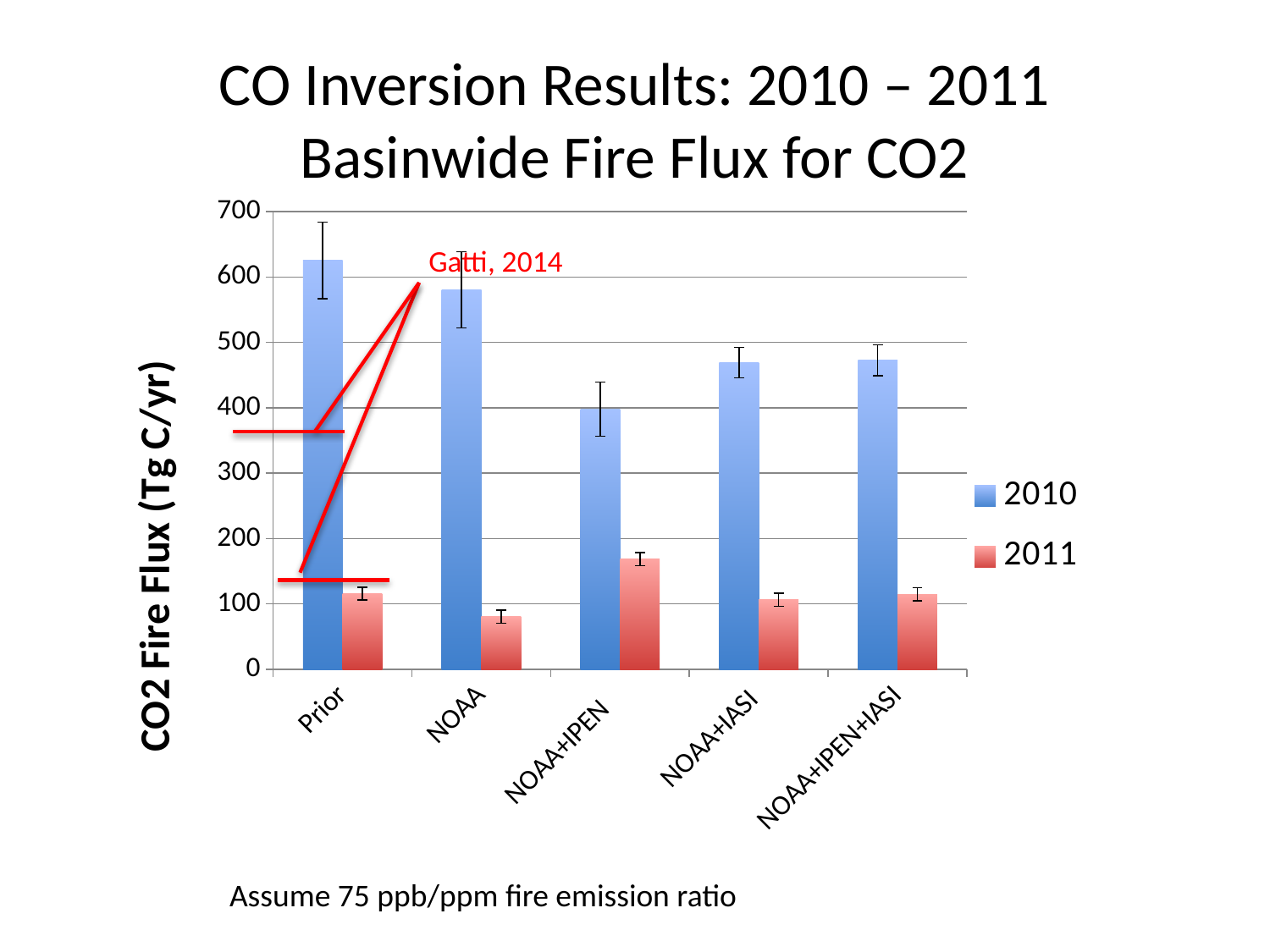
What is the label on the vertical axis? CO2 Fire Flux (Tg C/yr) Is the 2011 value for NOAA greater or less than 100? less Which category has the lowest 2010 value? NOAA+IPEN Is the 2011 value for NOAA+IPEN greater or less than 200? less How many categories are shown on the x axis? 5 Which category has the lowest 2011 value? NOAA What kind of chart is shown on the slide? bar chart Which category has the highest 2010 value? Prior How many series does the legend list? 2 Which category has the highest 2011 value? NOAA+IPEN For NOAA+IASI, which series has the larger value, 2010 or 2011? 2010 Is the 2010 value for Prior greater or less than 600? greater